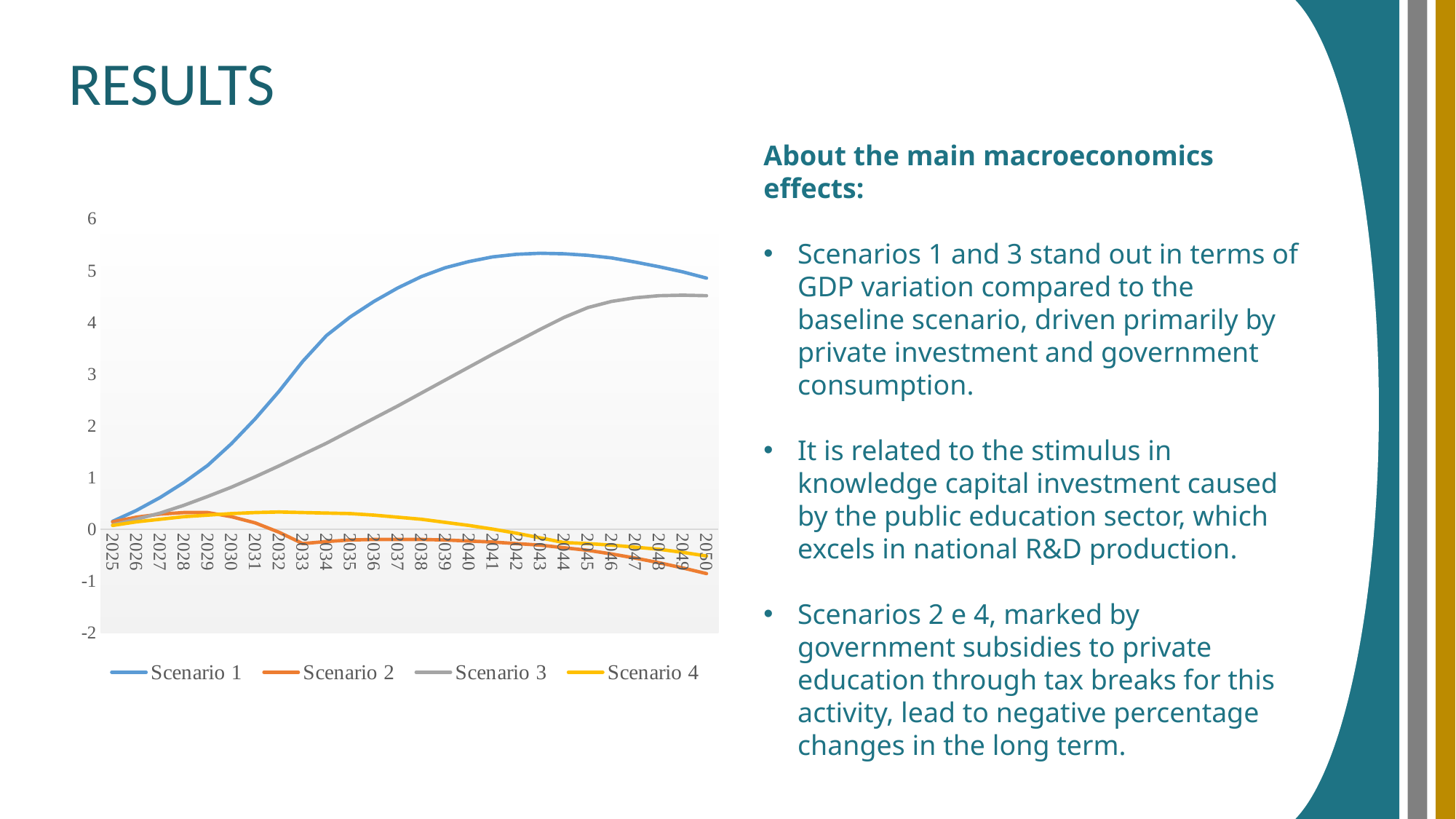
Which series reaches the highest value on the chart? Scenario 1 How many years are labelled along the x axis of the chart? 26 How many series does the chart's legend list? 4 Does the Scenario 3 line rise or fall from 2025 to 2045? rise What kind of chart is shown on the slide? line chart Is the value for Scenario 3 in 2050 greater or less than 4? greater Is the value for Scenario 2 in 2050 greater or less than 0? less Is the value for Scenario 1 in 2043 greater or less than 5? greater What colour is the Scenario 1 line in the chart? blue Which series has the lowest value in 2050? Scenario 2 In 2050, which is larger: the value for Scenario 1 or the value for Scenario 3? Scenario 1